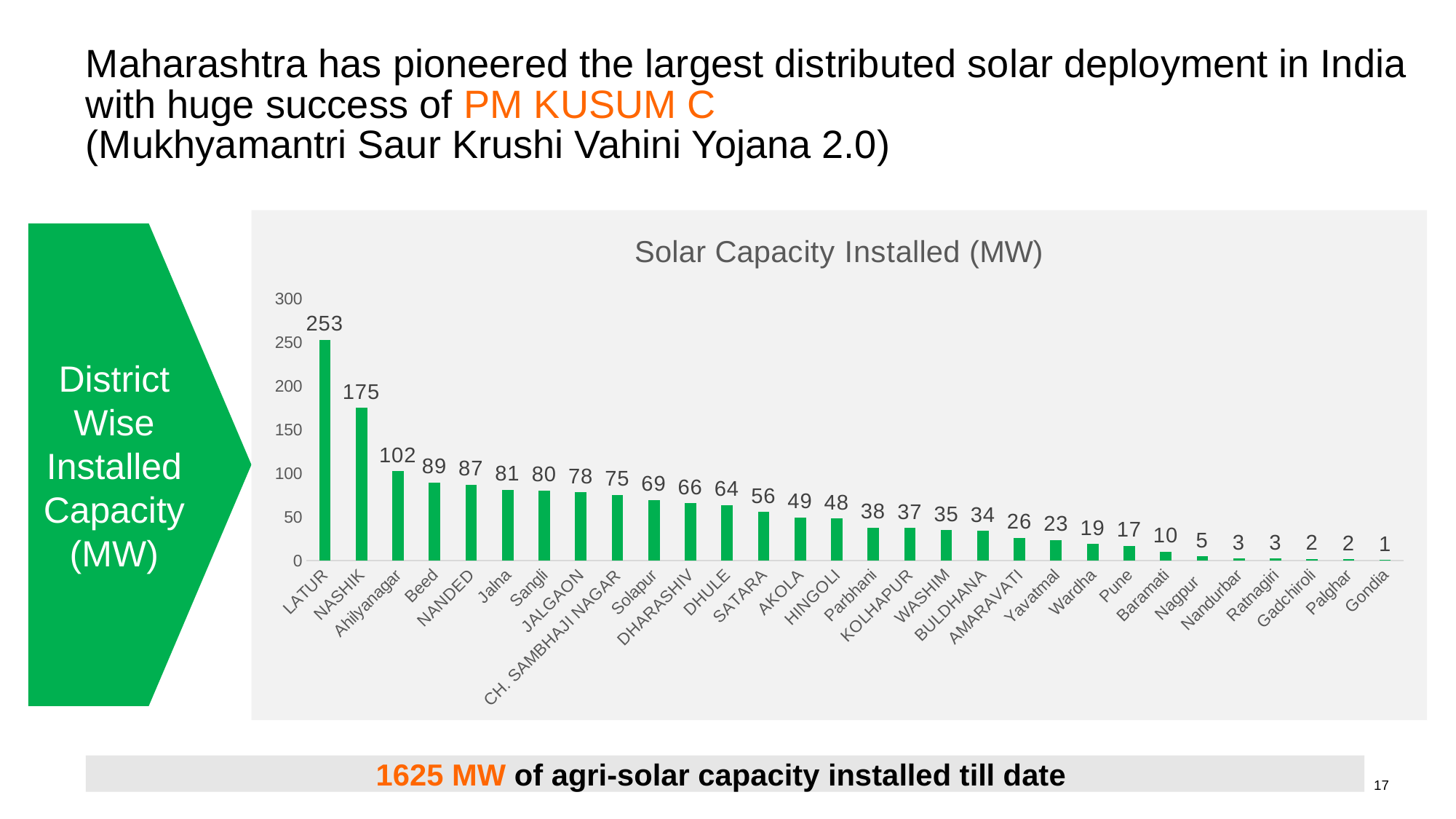
What is the solar capacity installed for KOLHAPUR? 37 What is the solar capacity installed for Ahilyanagar? 102 What kind of chart is shown on the slide? Bar chart What is the difference in solar capacity installed between LATUR and NASHIK? 78 How many districts are shown in the chart? 30 Which has a larger solar capacity installed, Beed or Solapur? Beed What is the solar capacity installed for LATUR? 253 Do the values rise or fall from left to right along the x axis? Fall Which district has the lowest solar capacity installed? Gondia What is the title of the chart? Solar Capacity Installed (MW) Which district has the highest solar capacity installed? LATUR Is the value for NASHIK greater or less than 150? greater